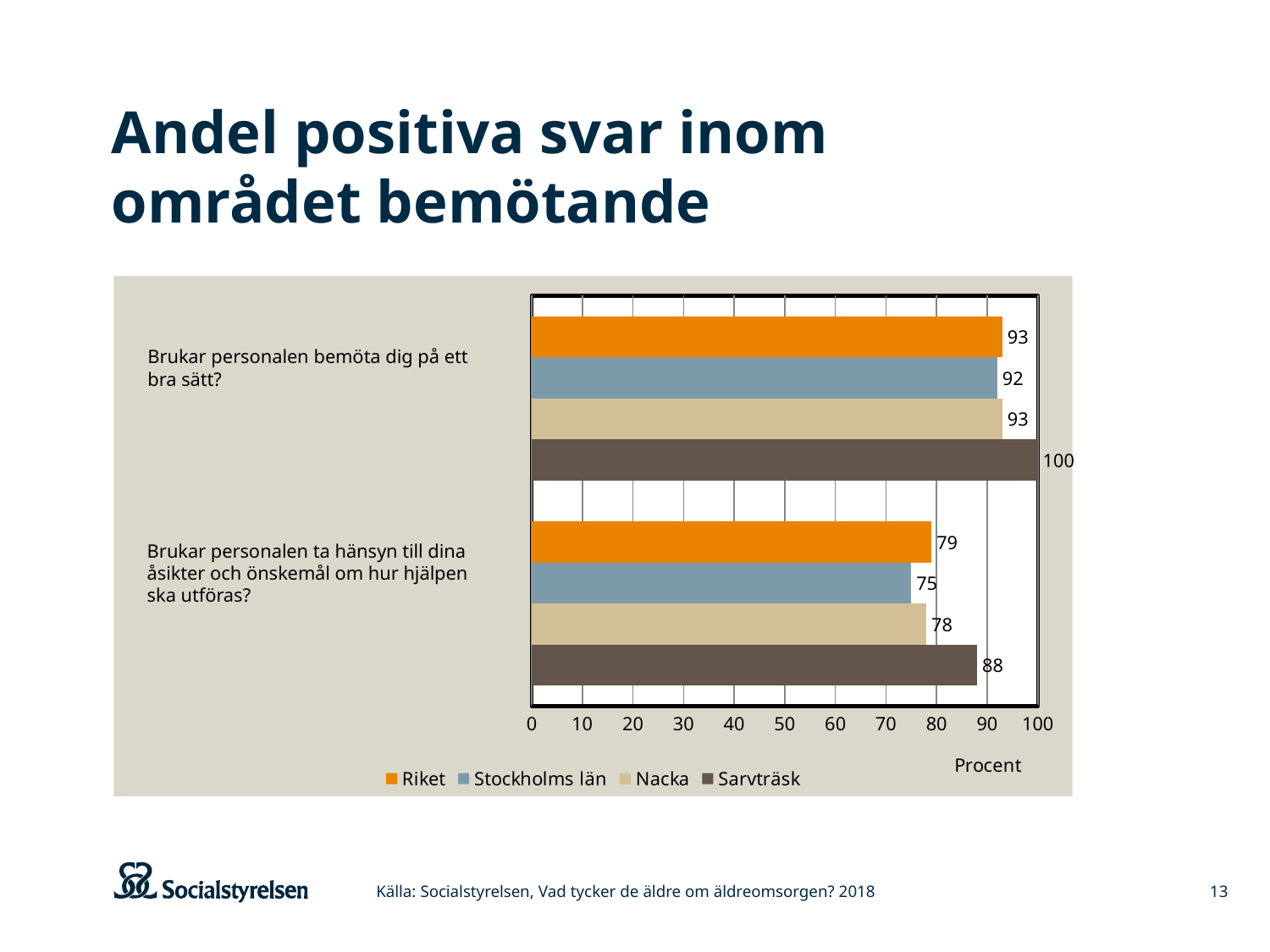
What is the value for Nacka on the question "Brukar personalen bemöta dig på ett bra sätt?"? 93 What is the label of the horizontal axis? Procent How many series does the legend list? 4 What is the difference between the Sarvträsk and Riket values on the question "Brukar personalen ta hänsyn till dina åsikter och önskemål om hur hjälpen ska utföras?"? 9 Which series has the lowest value on the question "Brukar personalen ta hänsyn till dina åsikter och önskemål om hur hjälpen ska utföras?"? Stockholms län Which is larger on the question "Brukar personalen bemöta dig på ett bra sätt?": the value for Sarvträsk or the value for Stockholms län? Sarvträsk What is the value for Sarvträsk on the question "Brukar personalen bemöta dig på ett bra sätt?"? 100 What is the value for Riket on the question "Brukar personalen ta hänsyn till dina åsikter och önskemål om hur hjälpen ska utföras?"? 79 How many questions (categories) are shown on the chart? 2 Which series has the highest value on the question "Brukar personalen ta hänsyn till dina åsikter och önskemål om hur hjälpen ska utföras?"? Sarvträsk What is the value for Stockholms län on the question "Brukar personalen ta hänsyn till dina åsikter och önskemål om hur hjälpen ska utföras?"? 75 What kind of chart is shown on the slide? Bar chart